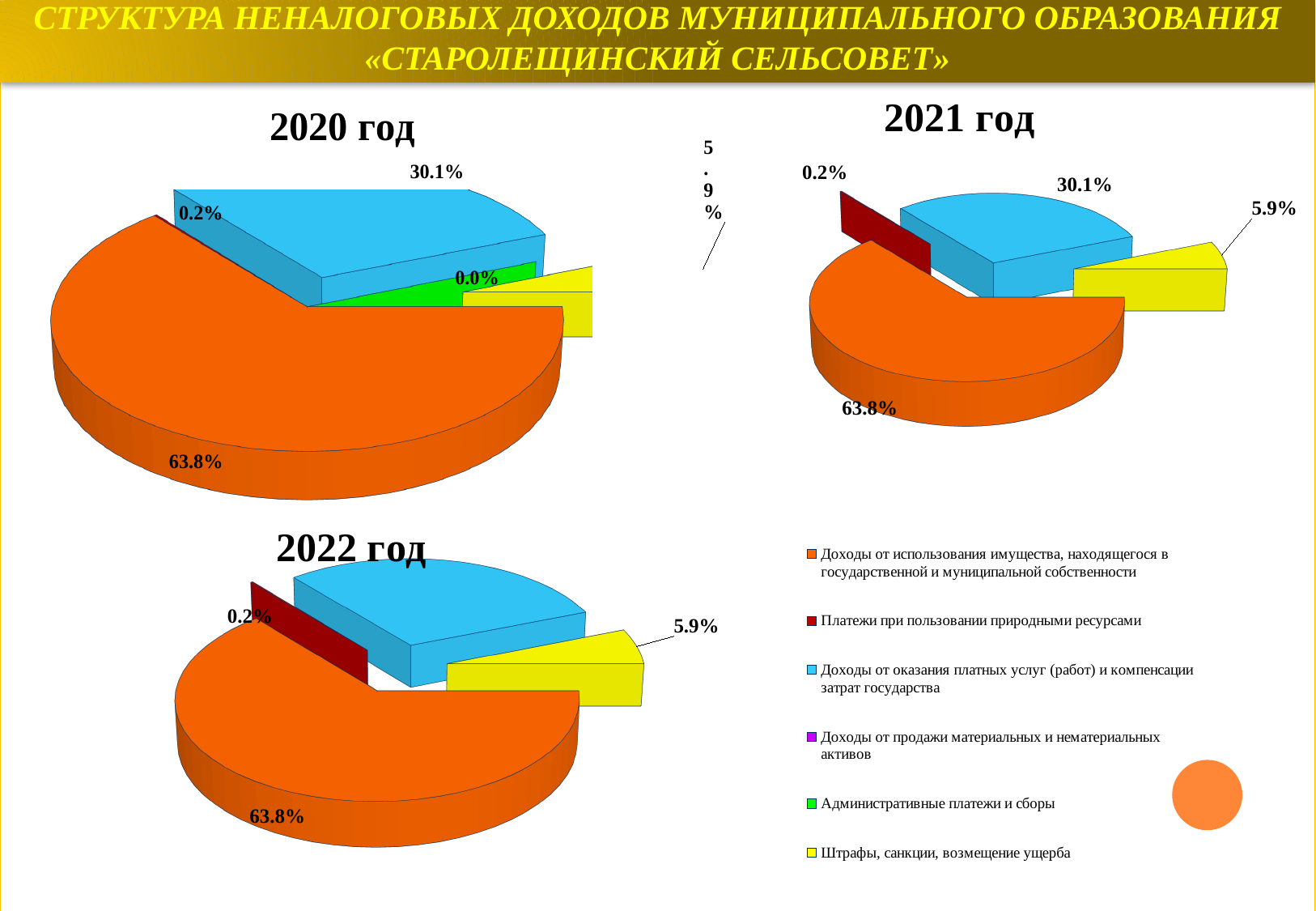
In the "2021 год" chart, what share is shown for the blue slice (Доходы от оказания платных услуг (работ) и компенсации затрат государства)? 30.1% In the "2022 год" chart, what share is shown for the yellow slice (Штрафы, санкции, возмещение ущерба)? 5.9% In the "2022 год" chart, what share is shown for the red slice (Платежи при пользовании природными ресурсами)? 0.2% How many entries does the legend list? 6 What kind of chart is used for the "2020 год" chart? pie chart In the "2021 год" chart, which is larger: the yellow slice (Штрафы, санкции, возмещение ущерба) or the blue slice (Доходы от оказания платных услуг)? the blue slice (Доходы от оказания платных услуг) In the "2020 год" chart, what share is shown for the orange slice (Доходы от использования имущества, находящегося в государственной и муниципальной собственности)? 63.8% In the "2022 год" chart, which of the labelled slices has the smallest share? Платежи при пользовании природными ресурсами In the "2021 год" chart, which category has the largest share? Доходы от использования имущества, находящегося в государственной и муниципальной собственности How many pie charts are shown on the slide? 3 In the "2020 год" chart, what is the difference between the orange slice (63.8%) and the blue slice (30.1%)? 33.7 percentage points In the "2020 год" chart, what share is shown for the green slice (Административные платежи и сборы)? 0.0%